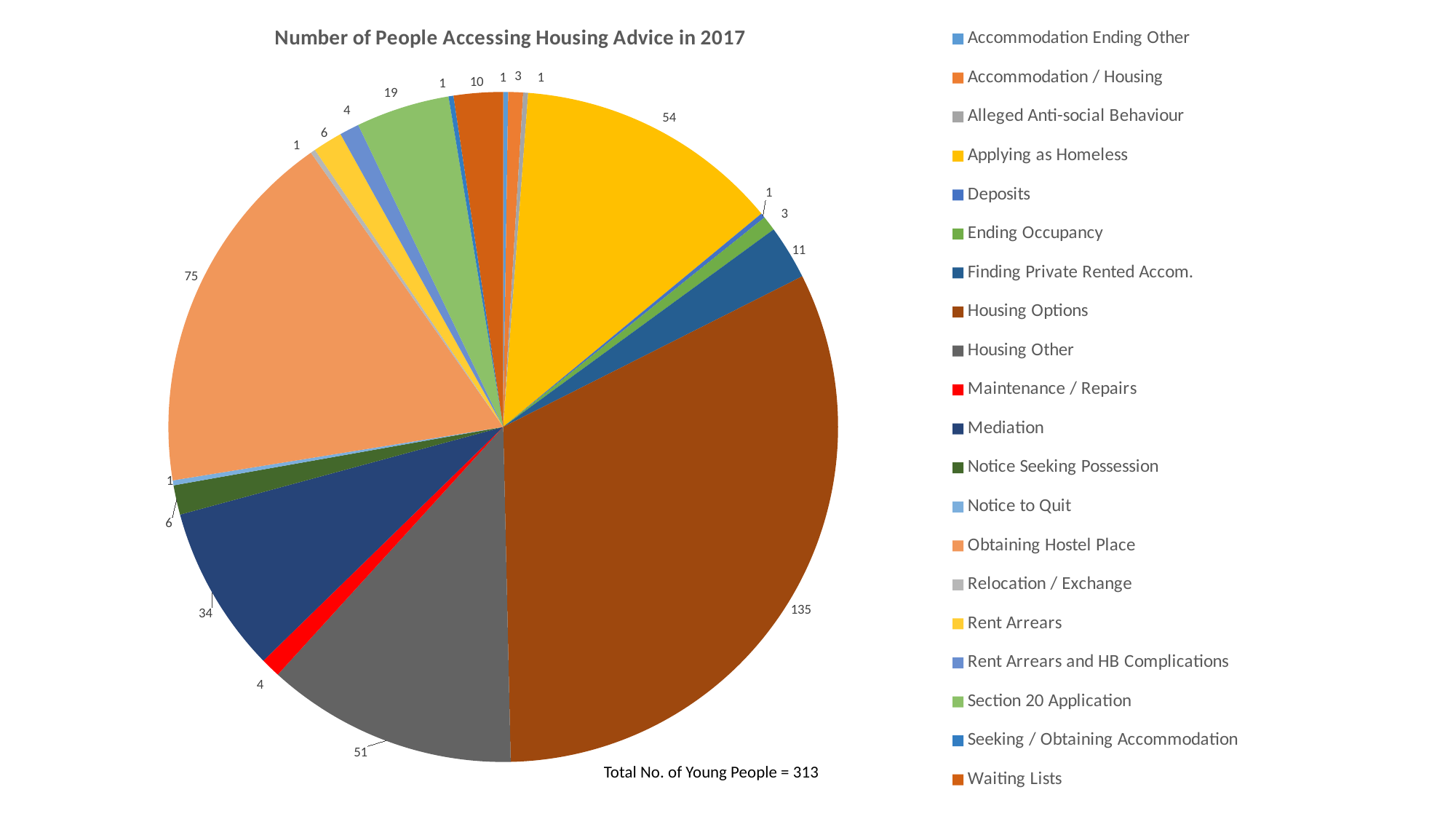
What is the value for Applying as Homeless? 54 What is the difference between the values for Housing Options and Housing Other? 84 What is the title of the chart? Number of People Accessing Housing Advice in 2017 What total number of young people is stated on the slide? 313 What is the value for Section 20 Application? 19 Which is larger, the value for Obtaining Hostel Place or the value for Applying as Homeless? Obtaining Hostel Place What is the value for Obtaining Hostel Place? 75 What type of chart is shown on the slide? pie chart How many categories does the legend list? 20 How many people accessed housing advice for Housing Options? 135 Which category has the largest slice of the pie? Housing Options What is the value for Mediation? 34